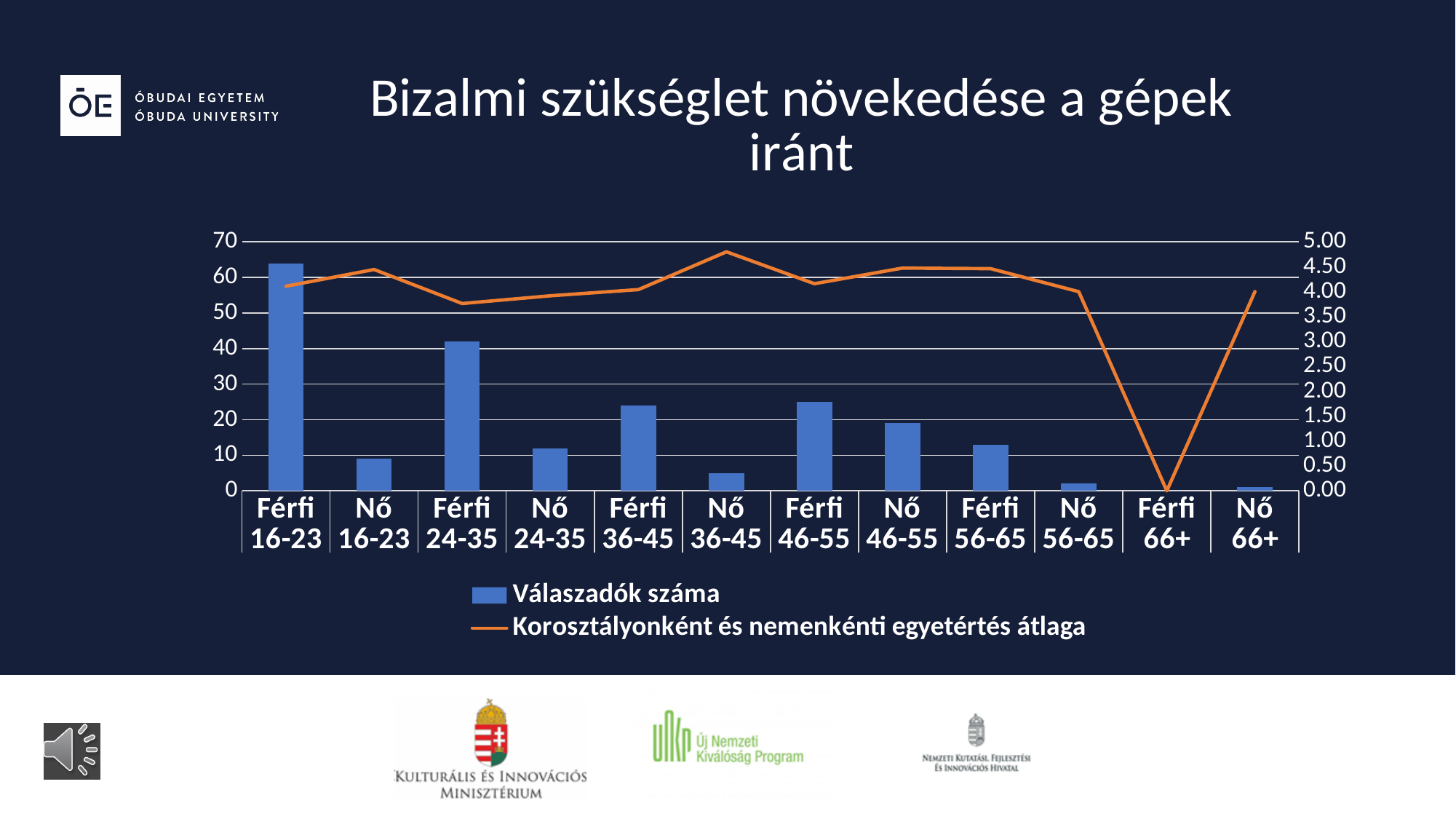
Is the Válaszadók száma bar for Férfi 16-23 greater or less than 60? greater Which has the larger Válaszadók száma bar, Férfi 24-35 or Férfi 36-45? Férfi 24-35 Which category has the highest bar for Válaszadók száma? Férfi 16-23 What is the value of the Korosztályonként és nemenkénti egyetértés átlaga line for Férfi 66+? 0.00 Which category has the highest value on the Korosztályonként és nemenkénti egyetértés átlaga line? Nő 36-45 What kind of chart is shown on the slide? A combination bar and line chart How many categories are shown on the x axis? 12 Which category has the lowest value on the Korosztályonként és nemenkénti egyetértés átlaga line? Férfi 66+ Is the Válaszadók száma bar for Férfi 24-35 greater or less than 40? greater How many series does the legend list? 2 What is the legend label of the orange line series? Korosztályonként és nemenkénti egyetértés átlaga